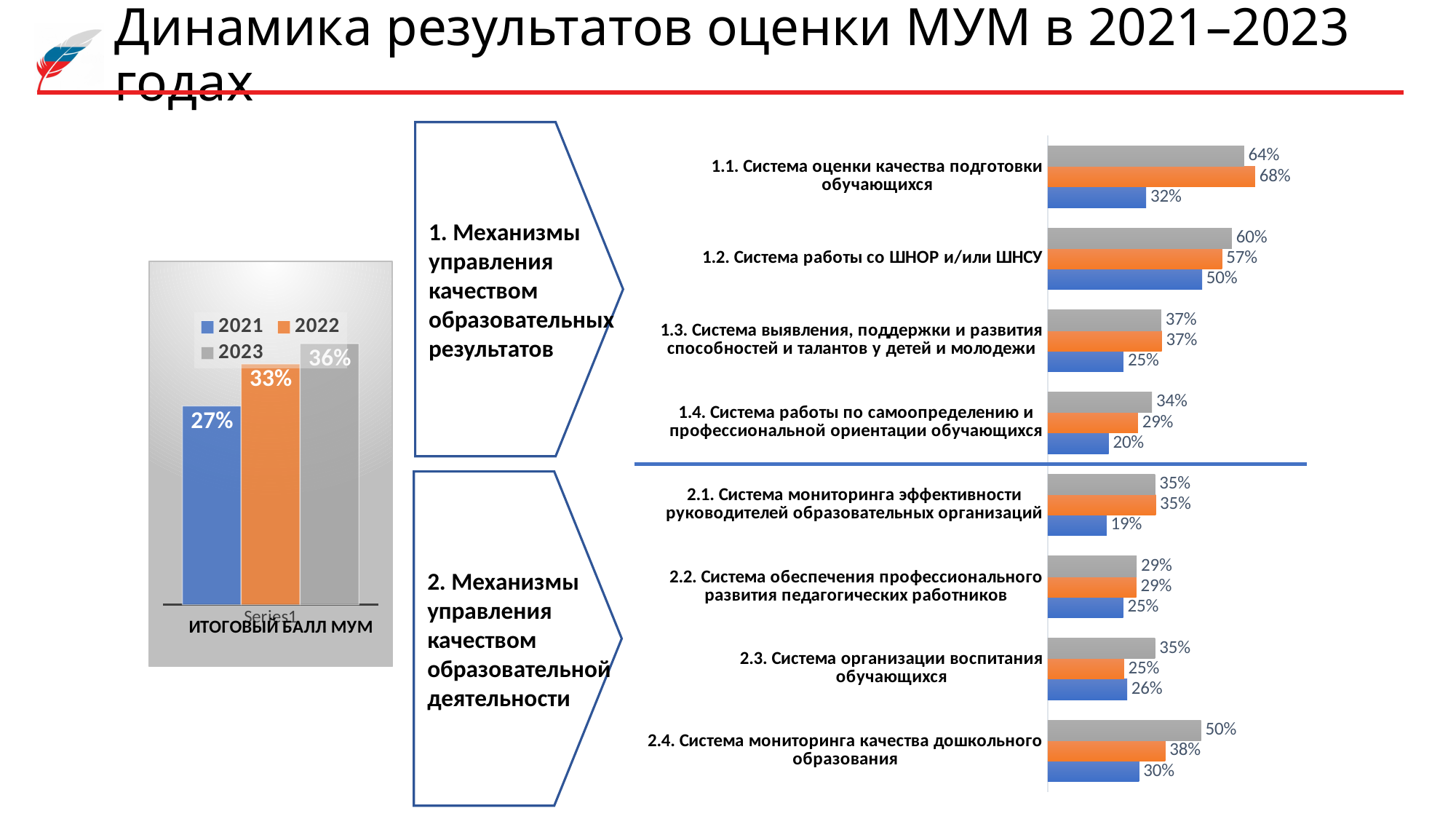
In the bar chart on the right, what is the value of the orange bar for category 1.1. Система оценки качества подготовки обучающихся? 68% In the bar chart on the right, for category 2.4. Система мониторинга качества дошкольного образования, what is the difference between the grey bar and the blue bar? 20% In the left chart titled ИТОГОВЫЙ БАЛЛ МУМ, what is the value for 2021? 27% In the bar chart on the right, which category has the lowest blue bar value? 2.1. Система мониторинга эффективности руководителей образовательных организаций In the left chart titled ИТОГОВЫЙ БАЛЛ МУМ, what is the difference between the 2023 and 2021 values? 9% In the left chart titled ИТОГОВЫЙ БАЛЛ МУМ, do the values rise or fall from 2021 to 2023? rise In the bar chart on the right, which category has the highest grey bar value? 1.1. Система оценки качества подготовки обучающихся How many series does the legend of the left chart titled ИТОГОВЫЙ БАЛЛ МУМ list? 3 How many categories are shown in the bar chart on the right side of the slide? 8 In the bar chart on the right, what is the value of the blue bar for category 2.1. Система мониторинга эффективности руководителей образовательных организаций? 19% In the left chart titled ИТОГОВЫЙ БАЛЛ МУМ, what is the value for 2023? 36% What kind of chart is the chart on the right side of the slide? bar chart